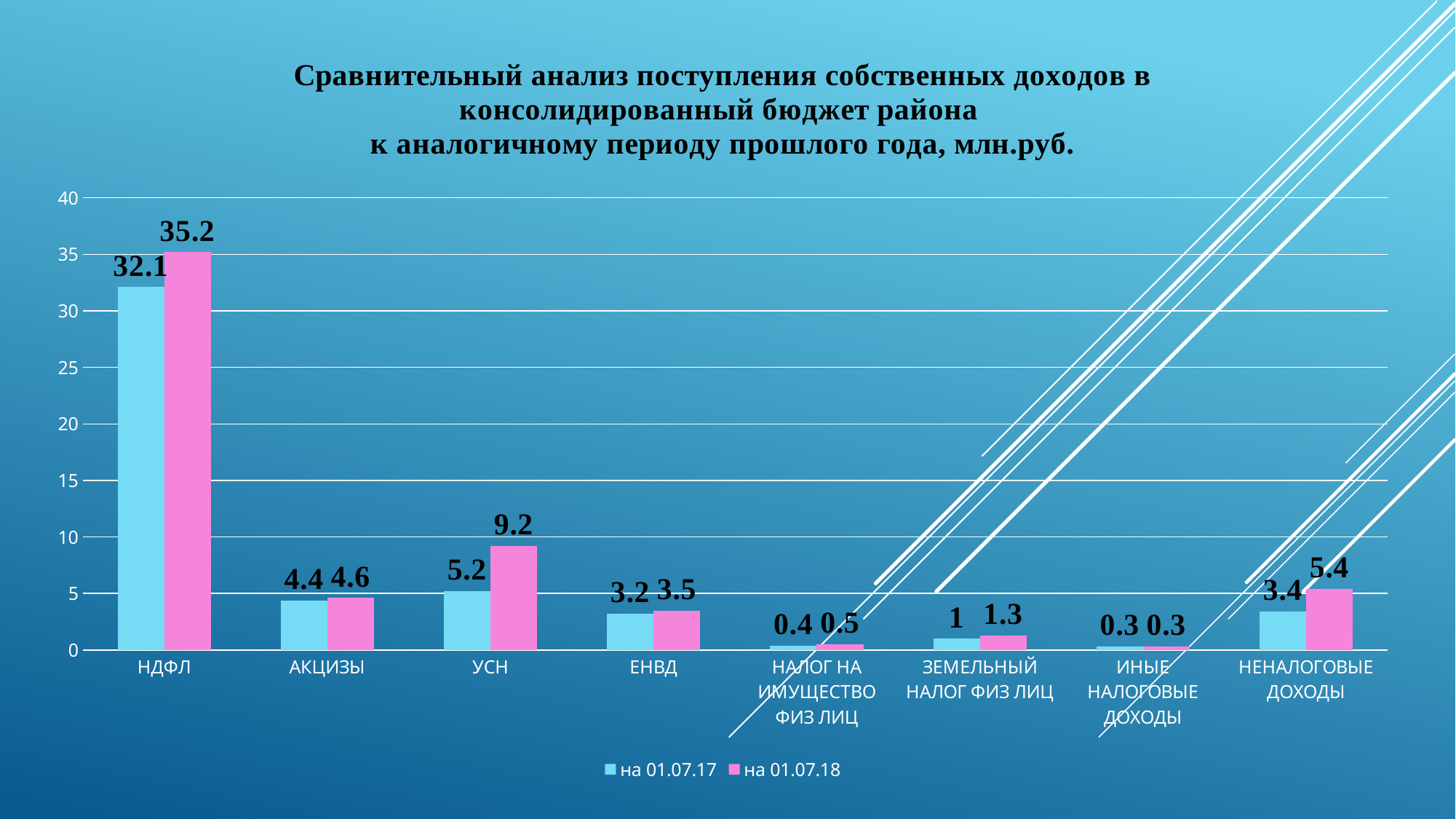
How many series does the legend list? 2 What is the value for УСН in the series на 01.07.17? 5.2 What is the value for ЗЕМЕЛЬНЫЙ НАЛОГ ФИЗ ЛИЦ in the series на 01.07.17? 1 What is the value for НЕНАЛОГОВЫЕ ДОХОДЫ in the series на 01.07.18? 5.4 Which category has the lowest value in the series на 01.07.18? ИНЫЕ НАЛОГОВЫЕ ДОХОДЫ How many categories are shown on the x axis? 8 What is the difference between the на 01.07.18 and на 01.07.17 values for НДФЛ? 3.1 Which category has the highest value in the series на 01.07.17? НДФЛ Which is larger for ЕНВД: the value на 01.07.17 or на 01.07.18? на 01.07.18 What is the value for НДФЛ in the series на 01.07.18? 35.2 What is the difference between the на 01.07.18 and на 01.07.17 values for УСН? 4 What kind of chart is shown on the slide? Bar chart